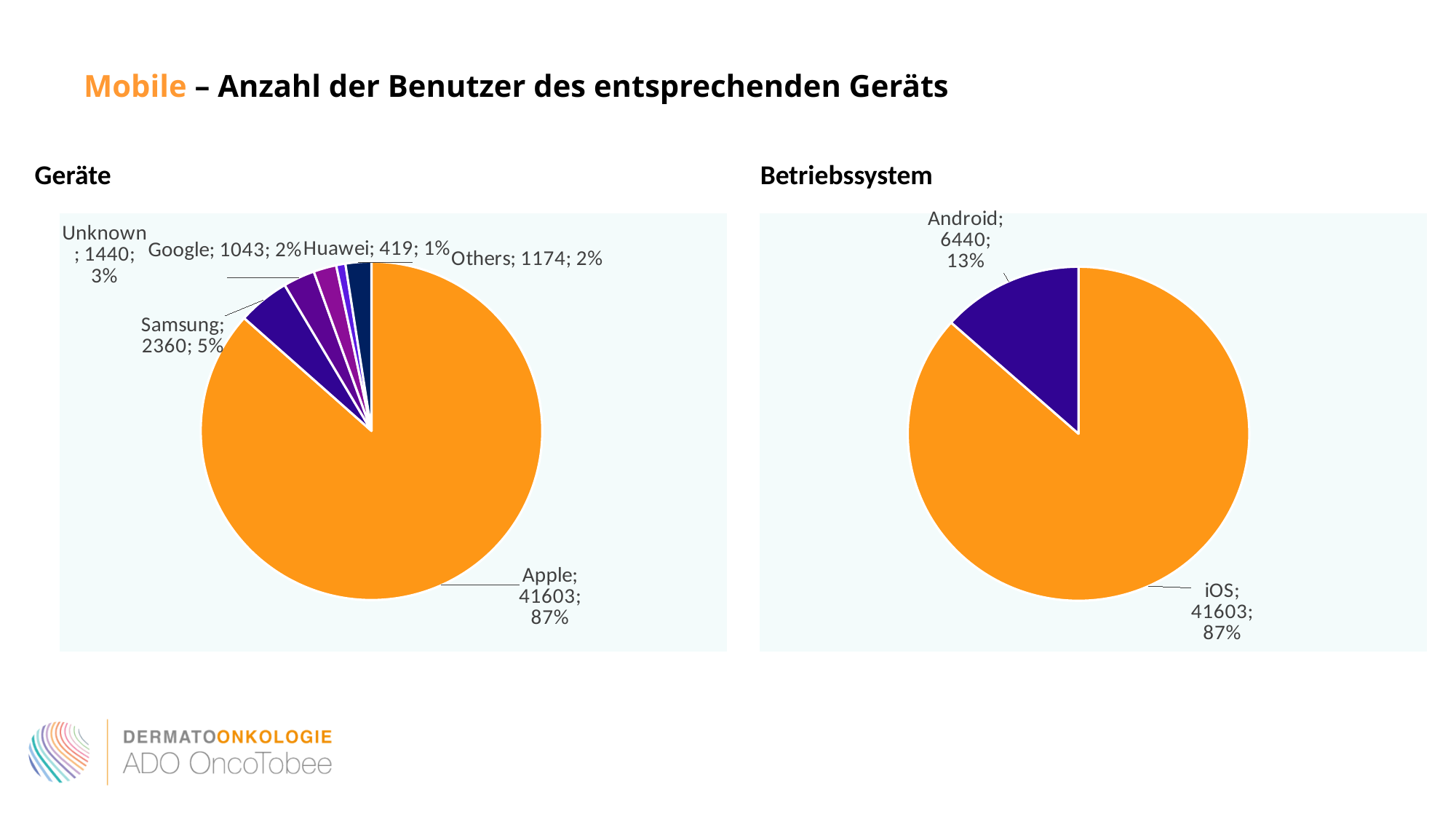
How many slices does the Geräte pie chart have? 6 In the Geräte chart, which device has the smallest number of users? Huawei In the Betriebssystem chart, how many users does Android have? 6440 What type of chart is the Betriebssystem chart? Pie chart In the Betriebssystem chart, what share of the pie does iOS represent? 87% In the Geräte chart, which has more users, Others or Unknown? Unknown In the Geräte chart, how many users does Apple have? 41603 In the Geräte chart, what share of the pie does Unknown represent? 3% In the Geräte chart, how many users does Samsung have? 2360 In the Geräte chart, which device has the largest number of users? Apple In the Betriebssystem chart, what is the difference in users between iOS and Android? 35163 In the Geräte chart, what is the difference in users between Samsung and Google? 1317